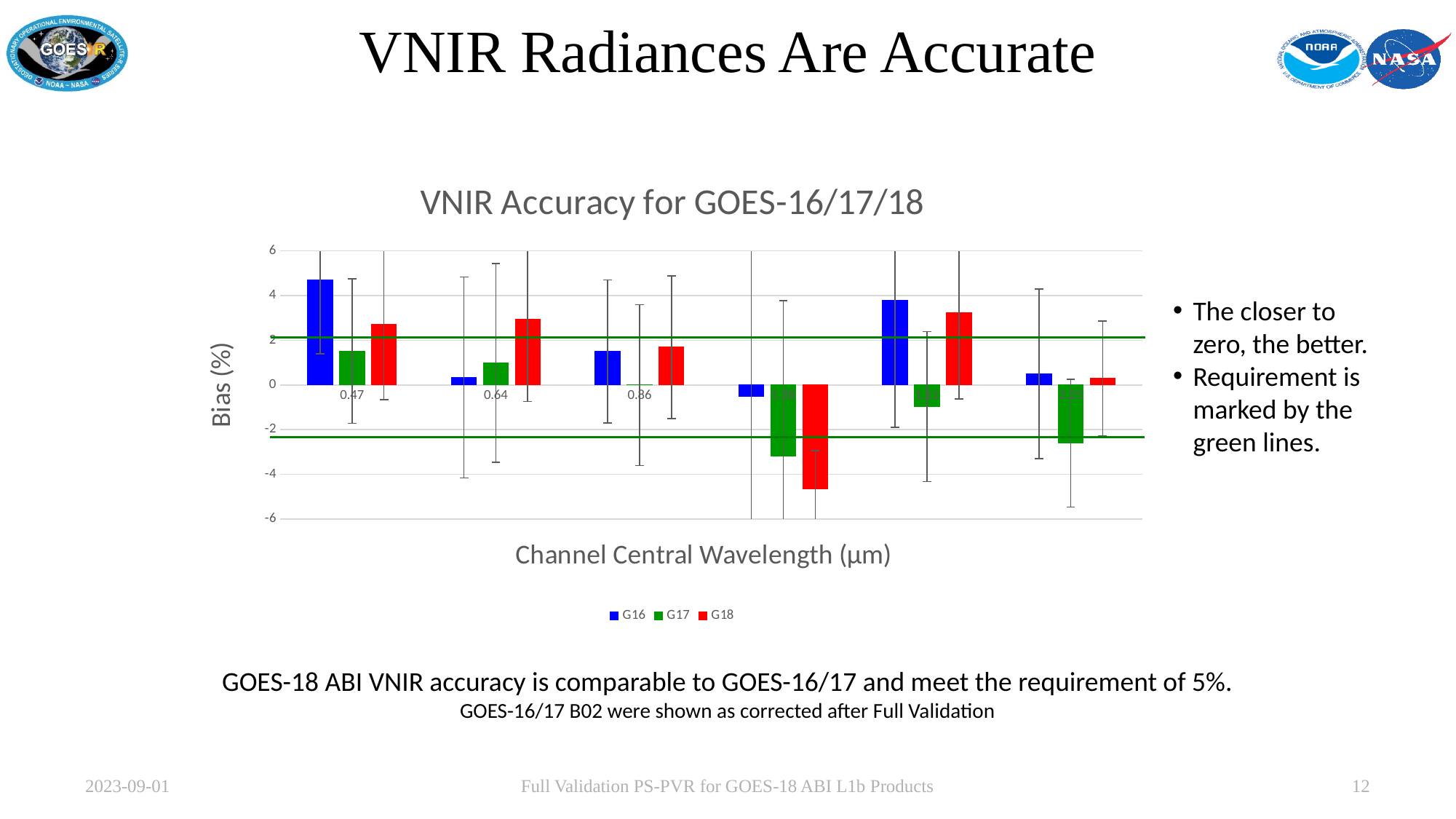
How many series does the legend of the chart list? 3 Is the G18 bias at 0.64 μm greater or less than 2? greater Is the G17 bias at 0.47 μm greater or less than 2? less Is the G16 bias at 0.47 μm greater or less than 4? greater At which channel central wavelength is the G16 bias highest? 0.47 At 0.64 μm, which series has the larger bias, G16 or G18? G18 What type of chart is shown on the slide? bar chart What is the title of the chart? VNIR Accuracy for GOES-16/17/18 At 0.86 μm, which series has the larger bias, G16 or G17? G16 What is the label of the vertical axis of the chart? Bias (%) At 0.47 μm, which series has the larger bias, G16 or G17? G16